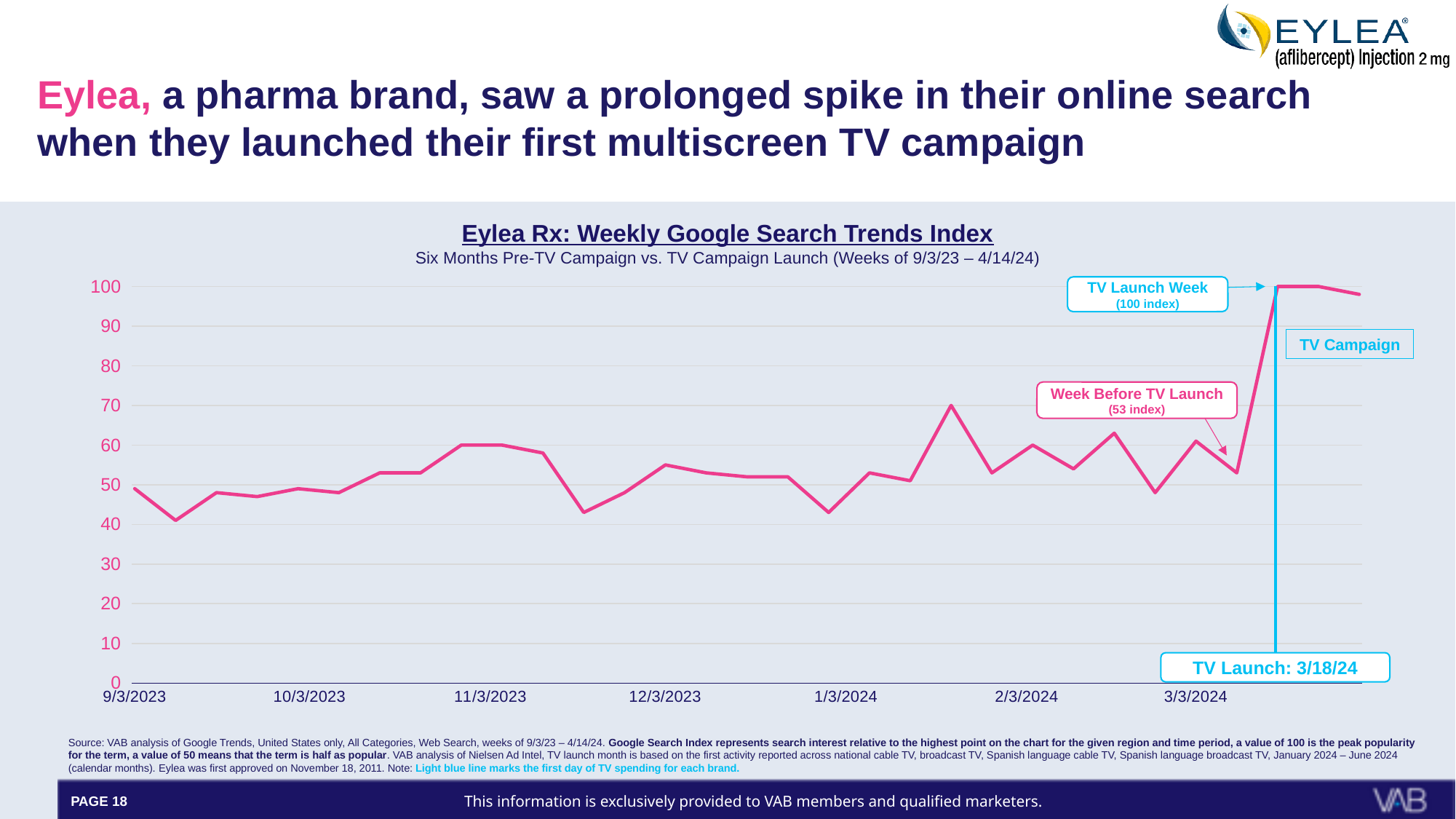
Which is larger, the index for the TV Launch Week or the Week Before TV Launch? TV Launch Week What is the title of the chart? Eylea Rx: Weekly Google Search Trends Index On what date was the TV campaign launched, according to the chart annotation? 3/18/24 How many date labels are shown on the x axis? 7 What kind of chart is shown on the slide? line chart What is the Google Search Trends Index value for the TV Launch Week? 100 index Which week has the highest index value on the chart? TV Launch Week By how much did the index rise from the Week Before TV Launch to the TV Launch Week? 47 Is the index value for the week of 9/3/2023 greater or less than 40? greater Is the index value for the week of 1/3/2024 greater or less than 50? less Is the highest index value before the TV launch greater or less than 60? greater What is the Google Search Trends Index value for the Week Before TV Launch? 53 index